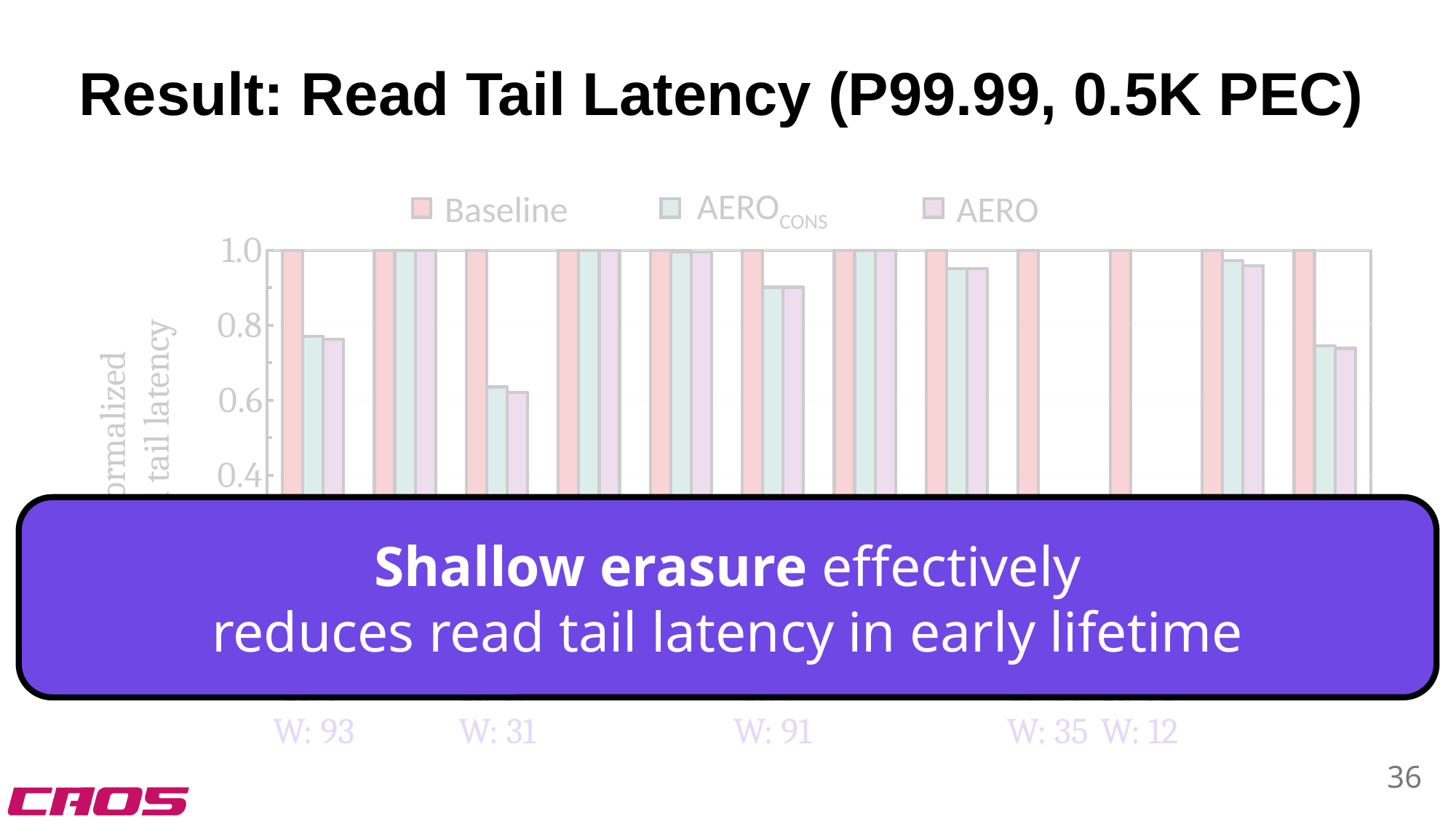
In the second group of bars from the left, is the AERO value greater or less than 0.6? greater What kind of chart is shown on the slide? bar chart What are the three series named in the chart's legend? Baseline, AERO_CONS, AERO In the second group of bars from the left, is the AERO_CONS value greater or less than 0.8? greater In the sixth group of bars from the left, is the AERO_CONS value greater or less than 0.8? greater How many groups of bars are plotted in the chart? 12 In the rightmost group of bars, which series has the lowest bar? AERO How many series does the chart's legend list? 3 In the leftmost group of bars, which is larger, the Baseline value or the AERO value? Baseline